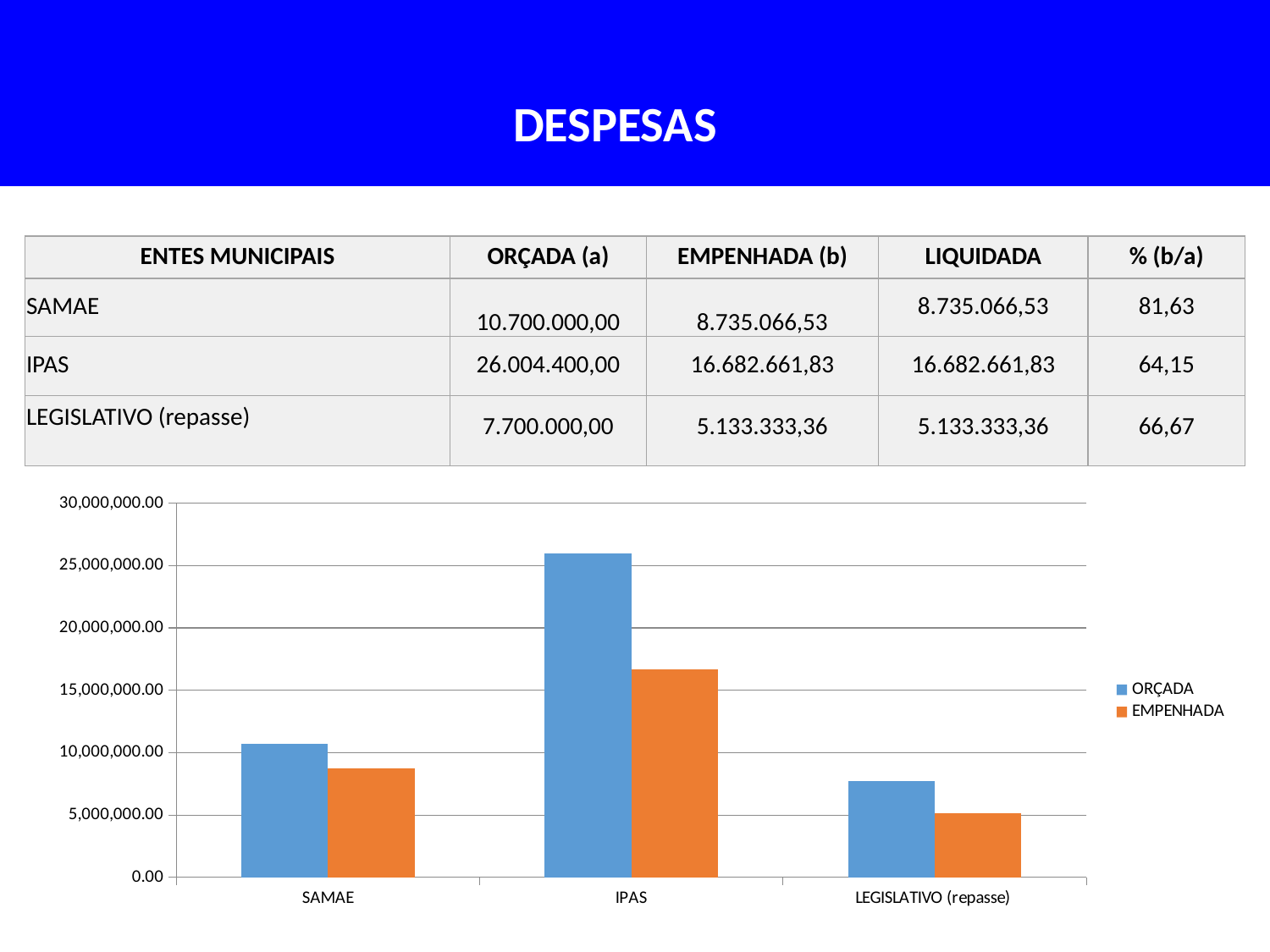
According to the slide, what is the EMPENHADA value for LEGISLATIVO (repasse)? 5.133.333,36 According to the slide, what is the ORÇADA value for IPAS? 26.004.400,00 Which category has the highest ORÇADA bar in the chart? IPAS Is the ORÇADA value for LEGISLATIVO (repasse) greater or less than 10,000,000.00? less Is the EMPENHADA value for SAMAE greater or less than 10,000,000.00? less What kind of chart is shown on the slide? bar chart Is the ORÇADA value for IPAS greater or less than 25,000,000.00? greater How many series does the chart legend list? 2 Which is larger, the ORÇADA bar for SAMAE or the ORÇADA bar for LEGISLATIVO (repasse)? SAMAE Which category has the lowest EMPENHADA bar in the chart? LEGISLATIVO (repasse) How many categories are shown on the x axis of the chart? 3 Which colour represents the EMPENHADA series in the chart? orange